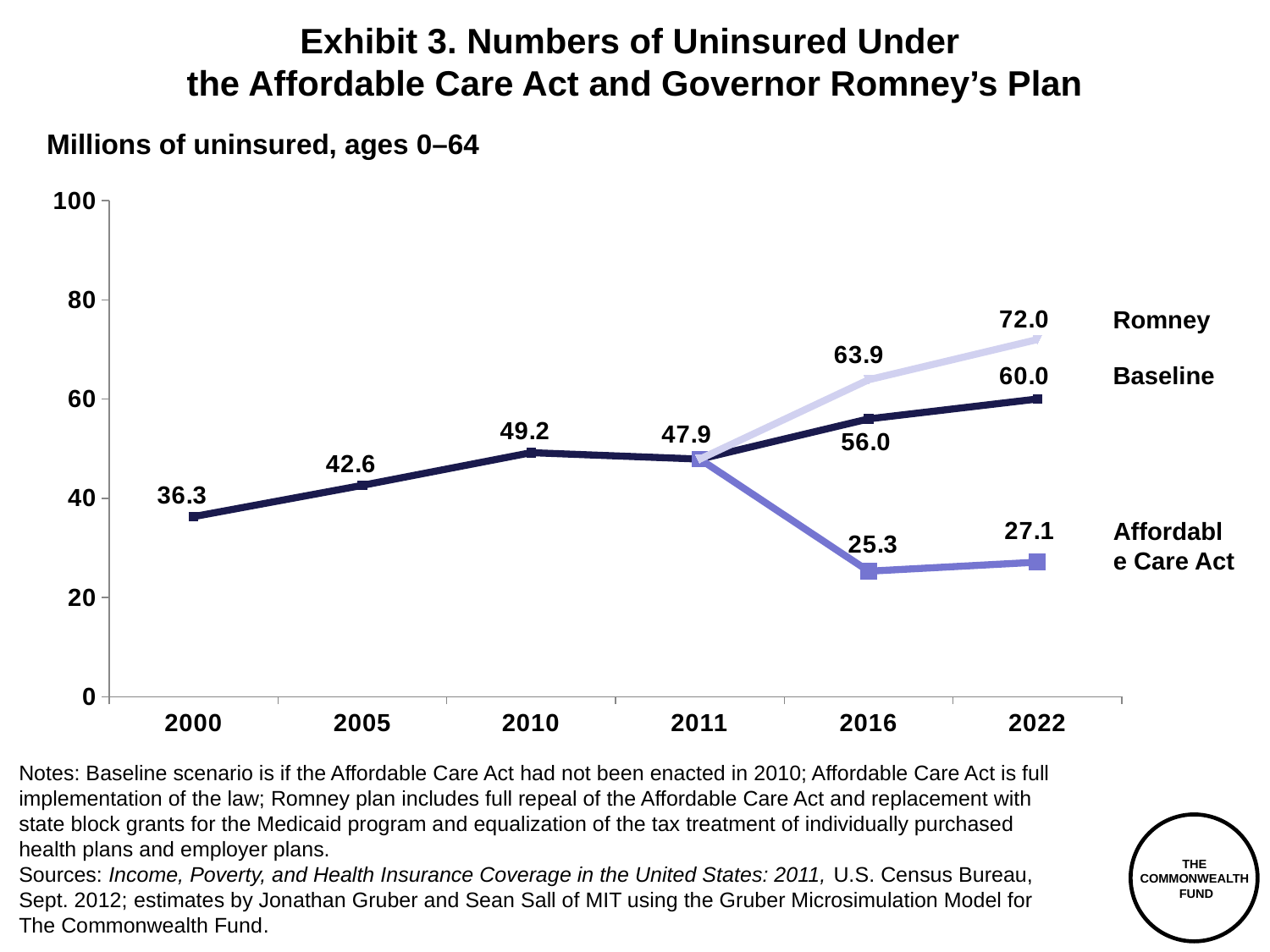
Is the Affordable Care Act value for 2022 greater or less than 40? less What is the Baseline value for 2016? 56.0 Does the Affordable Care Act line rise or fall between 2011 and 2016? fall What is the projected number of uninsured under the Romney plan in 2022? 72.0 What is the difference between the Romney and Affordable Care Act values in 2022? 44.9 Which scenario has the highest number of uninsured in 2022? Romney What kind of chart is shown on the slide? line chart What is the projected number of uninsured under the Affordable Care Act in 2016? 25.3 Which scenario has the lowest number of uninsured in 2022? Affordable Care Act What is the number of uninsured (millions) in 2000? 36.3 What is the difference between the Baseline and Affordable Care Act values in 2016? 30.7 Is the value for 2010 larger or smaller than the value for 2011? larger